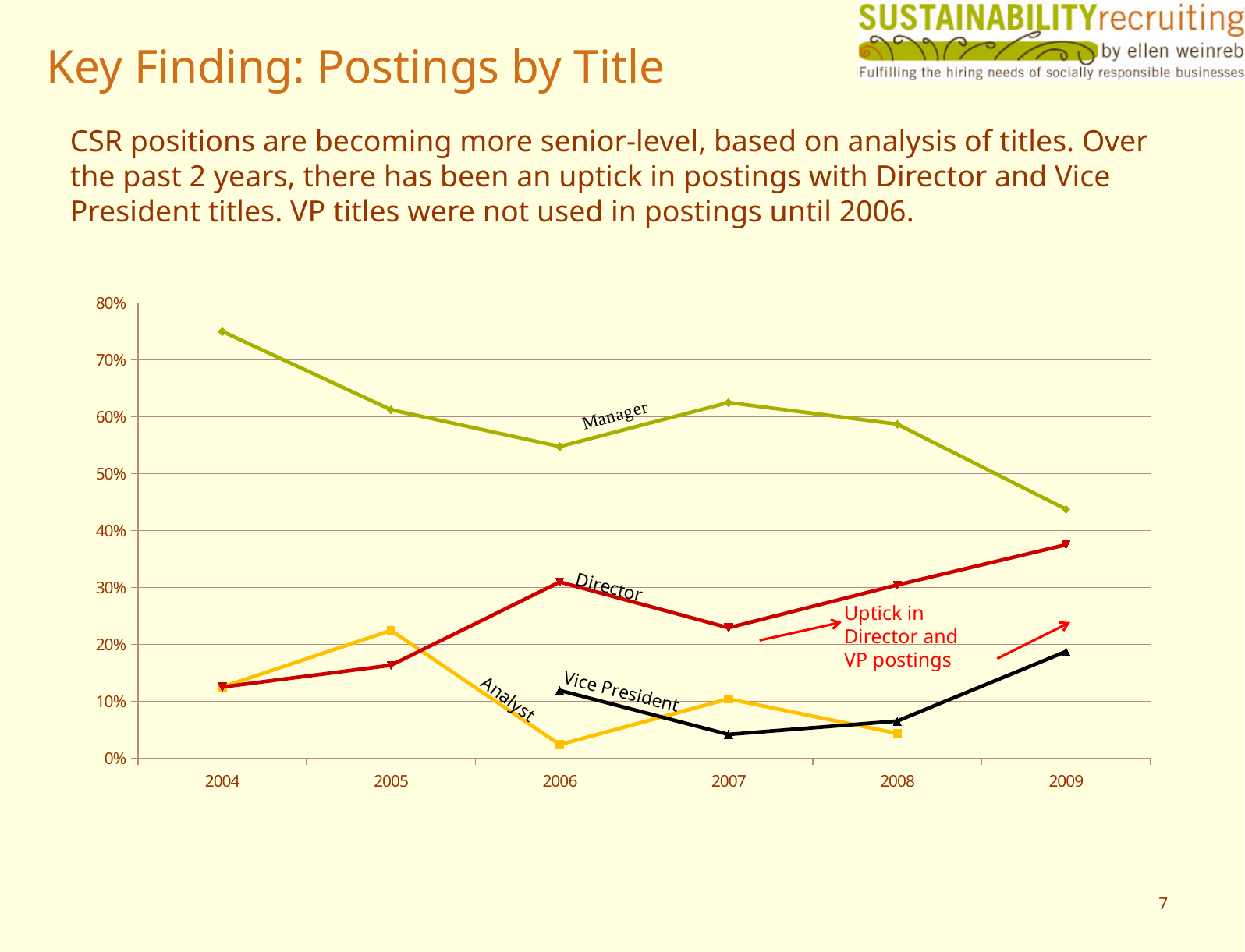
Does the Manager line rise or fall overall from 2004 to 2009? fall Is the value for Analyst in 2006 greater or less than 10%? less Is the value for Manager in 2004 greater or less than 70%? greater In 2009, which is larger: the value for Director or the value for Vice President? Director How many years are shown along the x axis of the chart? 6 What kind of chart is shown on the slide? line chart In which year does the Vice President line first appear on the chart? 2006 How many job-title series are plotted on the chart? 4 Is the value for Manager in 2009 greater or less than 50%? less Which job title has the highest share of postings in 2004? Manager In which year is the Manager series at its lowest? 2009